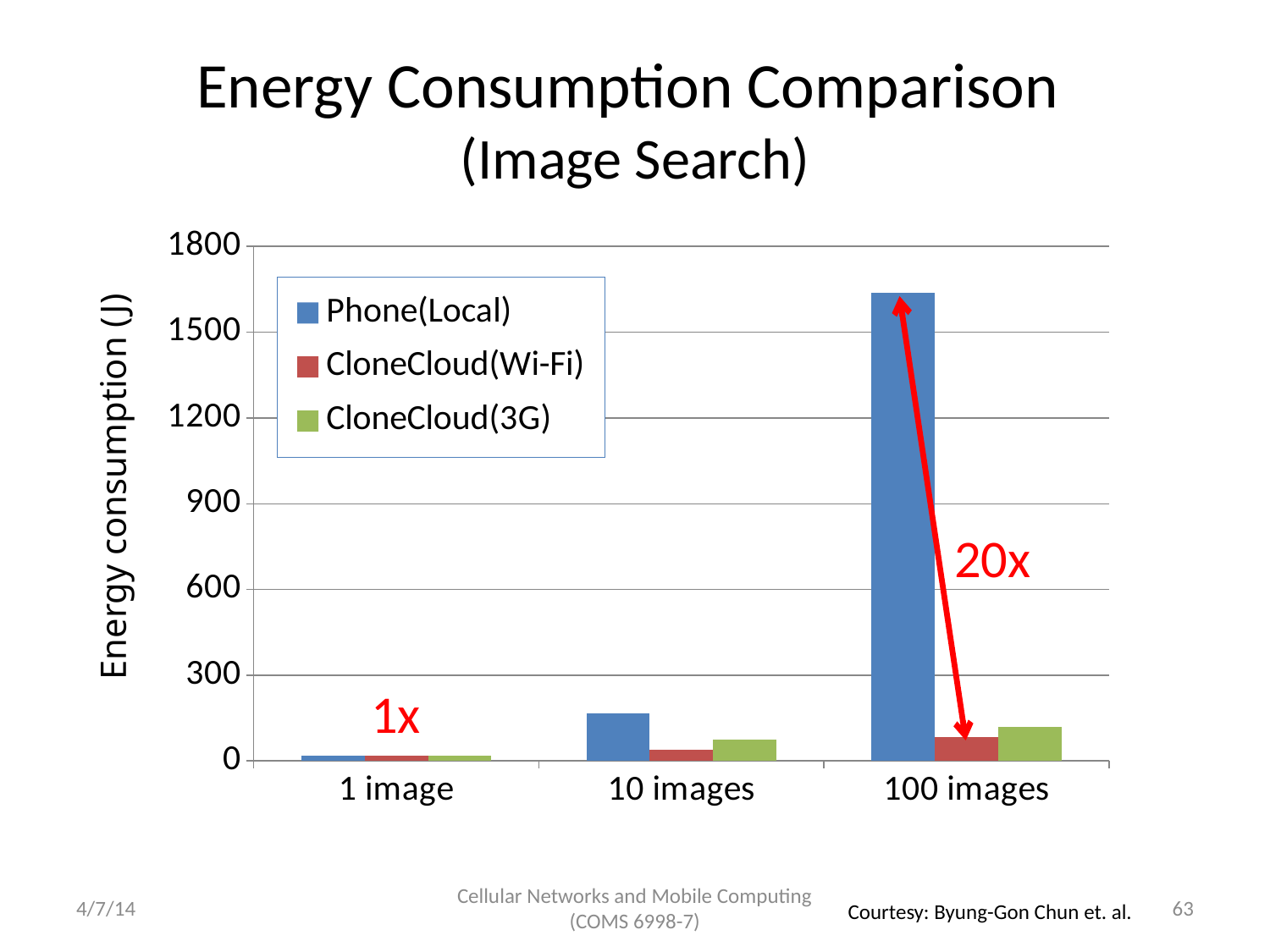
Does the Phone(Local) value rise or fall as the number of images increases along the x axis? rise What is the label of the y axis? Energy consumption (J) For 10 images, which is larger: CloneCloud(Wi-Fi) or CloneCloud(3G)? CloneCloud(3G) How many series does the legend list? 3 How many categories are shown on the x axis? 3 Is the Phone(Local) value for 10 images greater or less than 300? less What kind of chart is shown on the slide? bar chart Which series has the lowest value for 100 images? CloneCloud(Wi-Fi) Which category has the highest Phone(Local) value? 100 images Is the Phone(Local) value for 100 images greater or less than 1500? greater Which series has the highest value for 100 images? Phone(Local) What ratio is annotated in red next to the 100 images bars? 20x